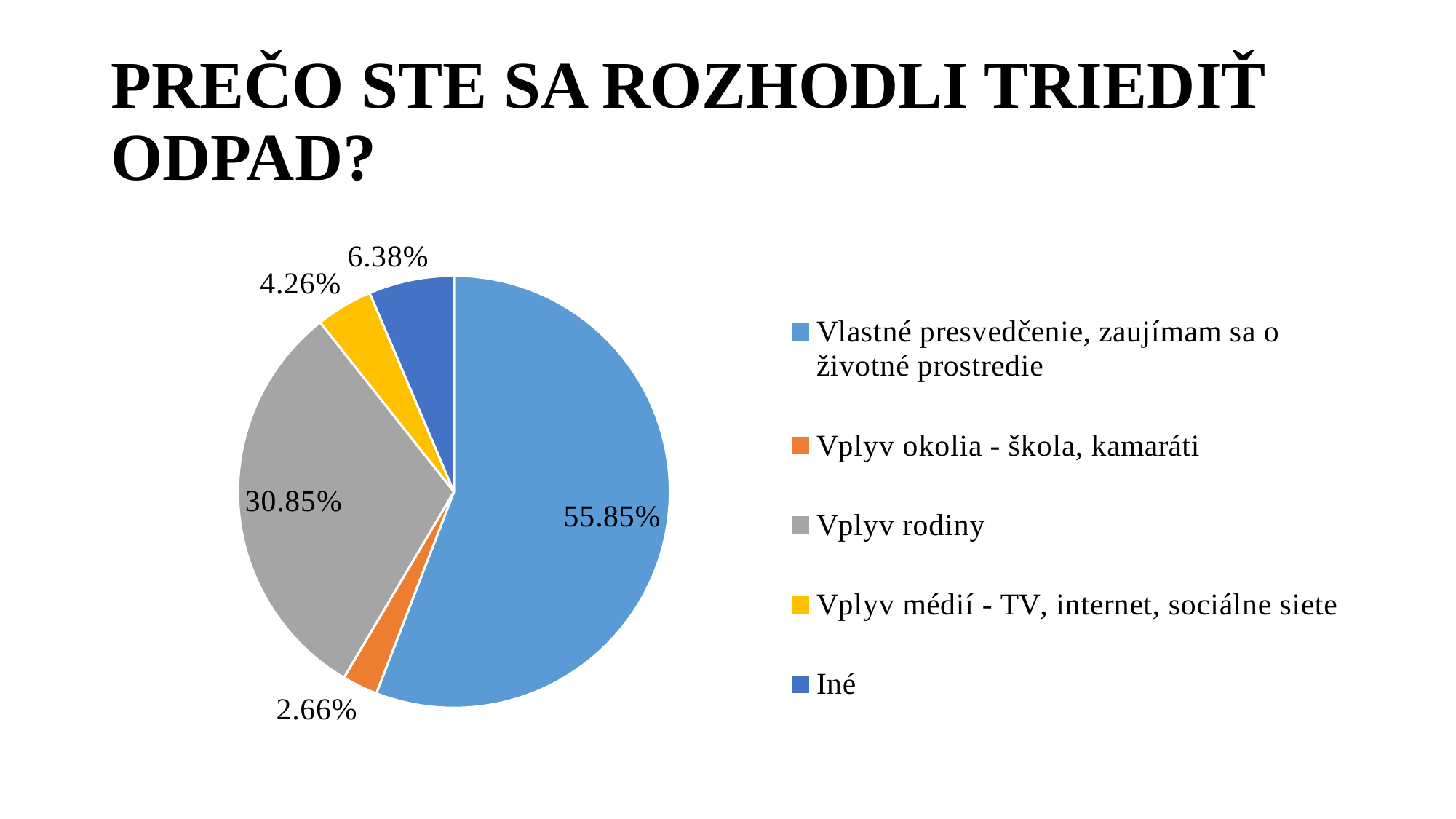
What kind of chart is shown on the slide? pie chart What is the difference between the shares of 'Vlastné presvedčenie, zaujímam sa o životné prostredie' and 'Vplyv rodiny'? 25% Which is larger: the share for 'Iné' or the share for 'Vplyv médií - TV, internet, sociálne siete'? Iné What share of the pie does 'Vplyv médií - TV, internet, sociálne siete' have? 4.26% How many categories does the pie chart have? 5 What share of the pie does 'Vlastné presvedčenie, zaujímam sa o životné prostredie' have? 55.85% What share of the pie does 'Vplyv okolia - škola, kamaráti' have? 2.66% What share of the pie does 'Vplyv rodiny' have? 30.85% Which category has the smallest slice of the pie? Vplyv okolia - škola, kamaráti Which category has the largest slice of the pie? Vlastné presvedčenie, zaujímam sa o životné prostredie What share of the pie does 'Iné' have? 6.38% What colour is the slice for 'Vplyv rodiny'? grey